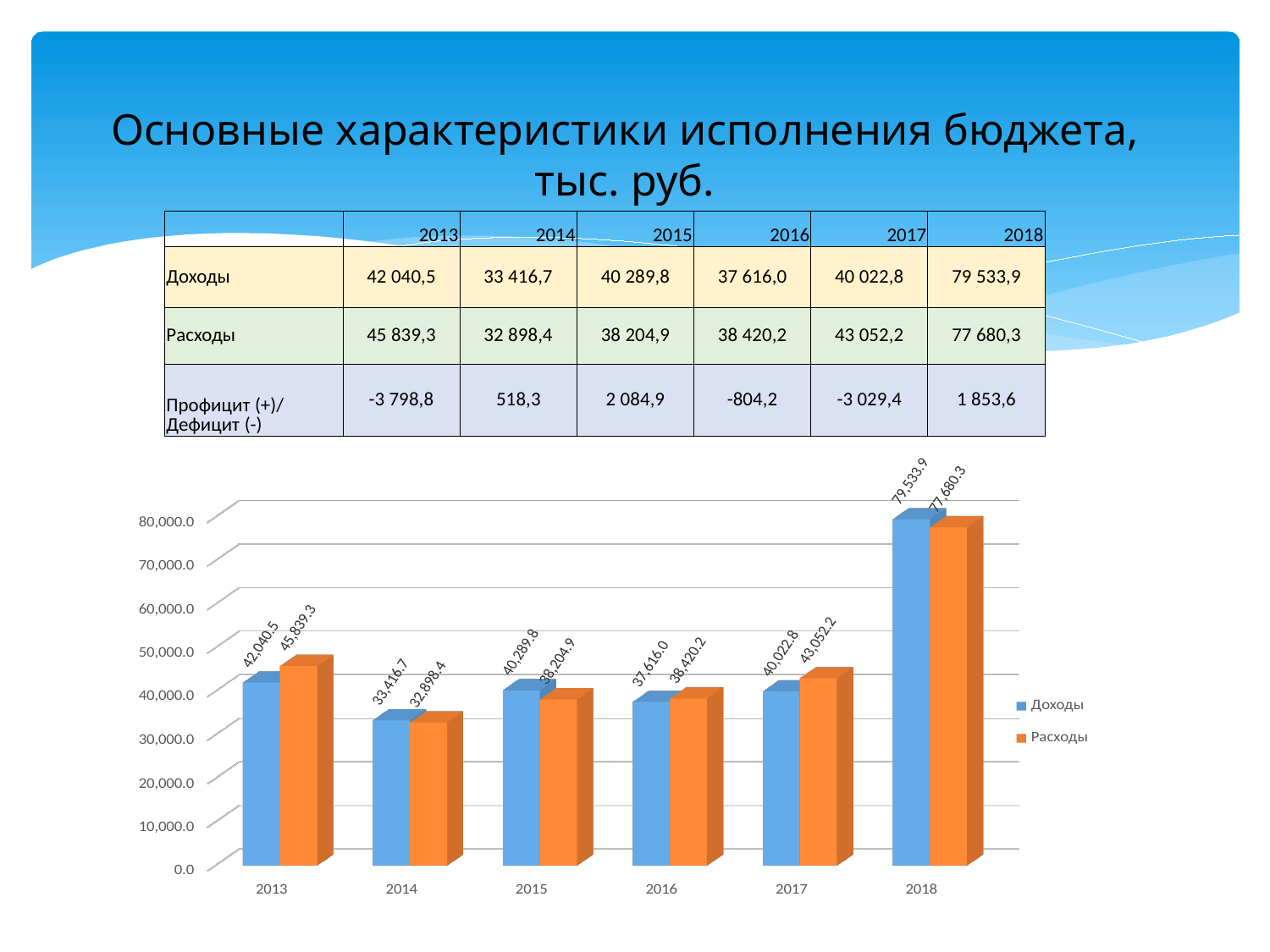
Which year has the lowest Доходы value in the chart? 2014 What is the value of Доходы for 2013 in the chart? 42,040.5 How many series does the chart legend list? 2 What is the difference between Расходы and Доходы for 2013 in the chart? 3,798.8 Is the value of Доходы for 2016 greater or less than 40,000.0? less What is the value of Доходы for 2018 in the chart? 79,533.9 How many years are shown on the x axis of the chart? 6 What is the value of Расходы for 2017 in the chart? 43,052.2 In 2015, which is larger in the chart: Доходы or Расходы? Доходы Which year has the highest Расходы value in the chart? 2018 Which colour represents Расходы in the chart? orange What kind of chart is shown on the slide? bar chart